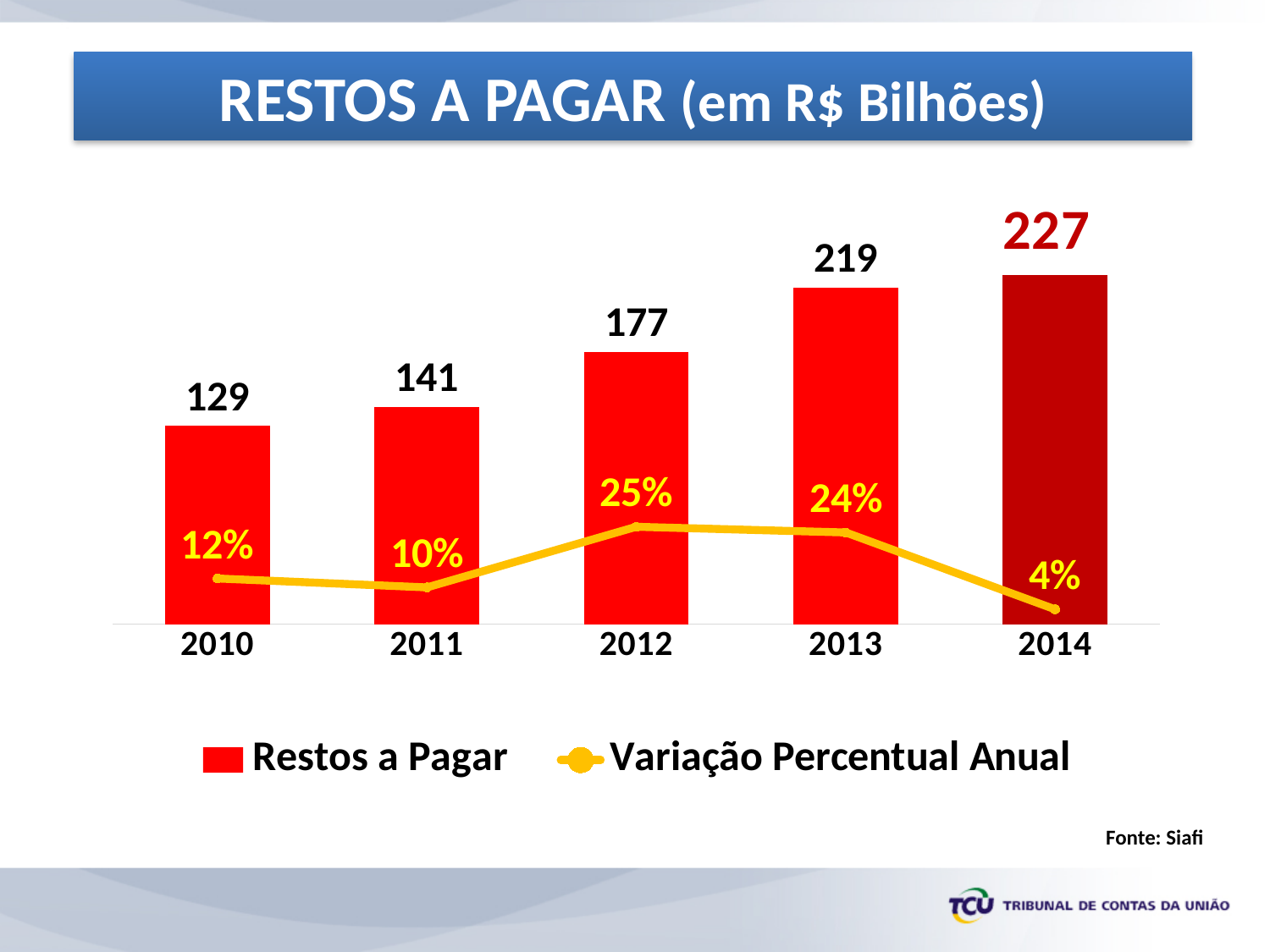
What is the value of Restos a Pagar for 2012? 177 Which year has the higher Variação Percentual Anual, 2012 or 2013? 2012 Which year has the lowest Variação Percentual Anual? 2014 What is the source cited for the chart? Siafi Do the Restos a Pagar values rise or fall from 2010 to 2014? Rise How many series does the legend list? 2 How many years are shown on the x axis? 5 What is the Variação Percentual Anual for 2014? 4% What is the difference between the Restos a Pagar values for 2014 and 2010? 98 What kind of chart is used for the Restos a Pagar series? Bar chart What is the title of the chart? RESTOS A PAGAR (em R$ Bilhões) Which year has the highest Restos a Pagar value? 2014